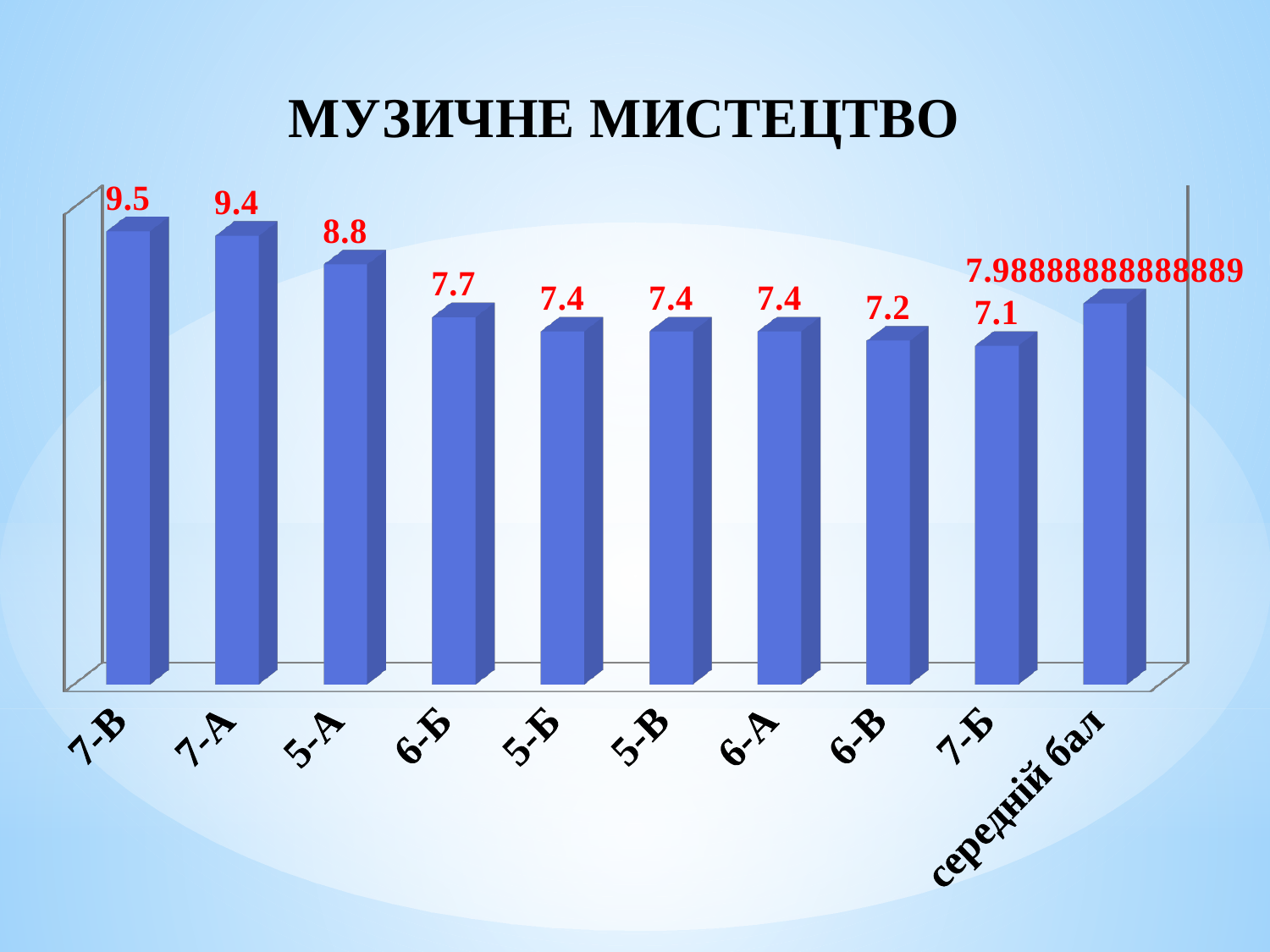
What is the difference between the values for 7-В and 7-Б? 2.4 What is the title of the chart? МУЗИЧНЕ МИСТЕЦТВО What is the value for 5-А? 8.8 Which is larger, the value for 7-А or the value for 6-Б? 7-А What kind of chart is shown on the slide? Bar chart Which class has the highest value? 7-В What is the value for 7-В? 9.5 What is the difference between the values for 5-А and 6-Б? 1.1 How many bars are shown in the chart? 10 What is the value for 6-В? 7.2 Which class has the lowest value? 7-Б What is the value shown for середній бал? 7.98888888888889